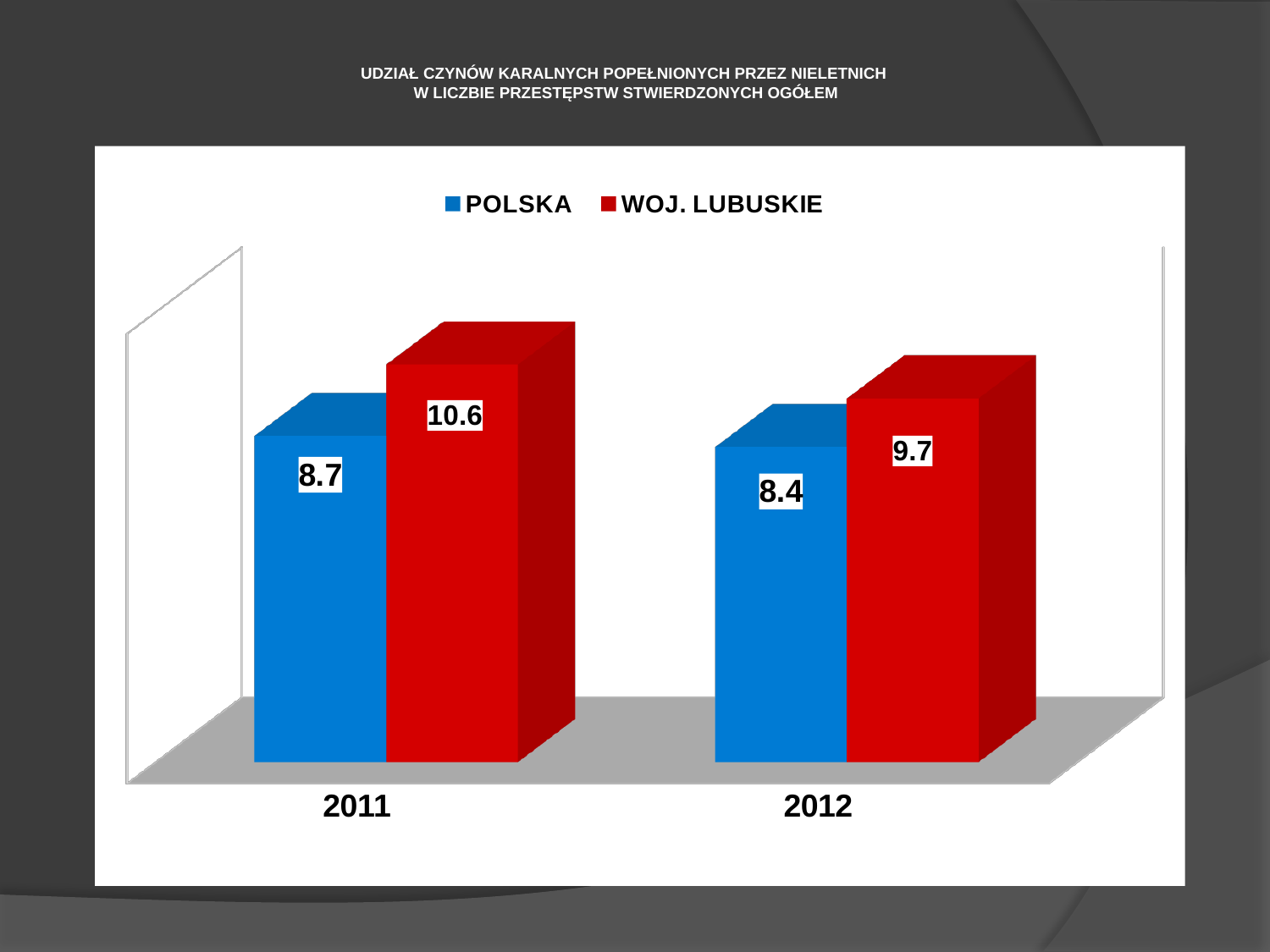
What is the value for POLSKA in 2011? 8.7 What is the value for WOJ. LUBUSKIE in 2011? 10.6 Which is larger in 2012, POLSKA or WOJ. LUBUSKIE? WOJ. LUBUSKIE What is the value for WOJ. LUBUSKIE in 2012? 9.7 What is the difference between WOJ. LUBUSKIE and POLSKA in 2011? 1.9 What is the difference between WOJ. LUBUSKIE and POLSKA in 2012? 1.3 How many series does the legend list? 2 What kind of chart is shown on the slide? bar chart How many years are shown on the x axis? 2 What is the value for POLSKA in 2012? 8.4 Which year has the highest value for WOJ. LUBUSKIE? 2011 Which year has the lowest value for POLSKA? 2012